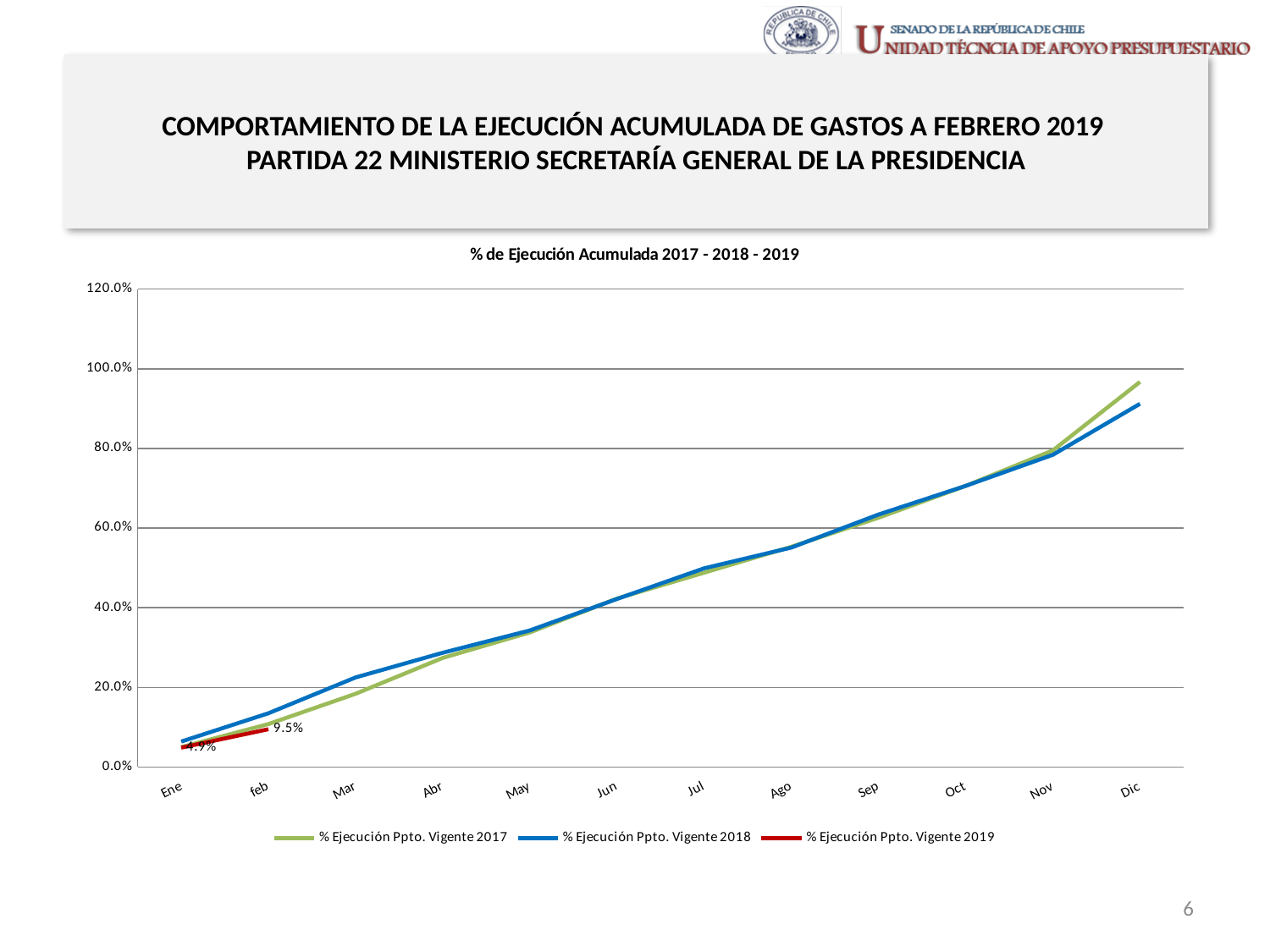
Is the value of % Ejecución Ppto. Vigente 2018 for Dic greater or less than 100.0%? less In Dic, which series has the higher value: % Ejecución Ppto. Vigente 2017 or % Ejecución Ppto. Vigente 2018? % Ejecución Ppto. Vigente 2017 What is the value of % Ejecución Ppto. Vigente 2019 for feb? 9.5% In Mar, which series has the higher value: % Ejecución Ppto. Vigente 2017 or % Ejecución Ppto. Vigente 2018? % Ejecución Ppto. Vigente 2018 How many series does the legend list? 3 How many months are shown along the x axis? 12 Is the value of % Ejecución Ppto. Vigente 2017 for Dic greater or less than 80.0%? greater What is the title of the chart? % de Ejecución Acumulada 2017 - 2018 - 2019 What kind of chart is shown on the slide? line chart In which month does % Ejecución Ppto. Vigente 2017 reach its highest value? Dic Is the value of % Ejecución Ppto. Vigente 2018 for Jun greater or less than 60.0%? less Do the values of % Ejecución Ppto. Vigente 2018 rise or fall from Ene to Dic? rise